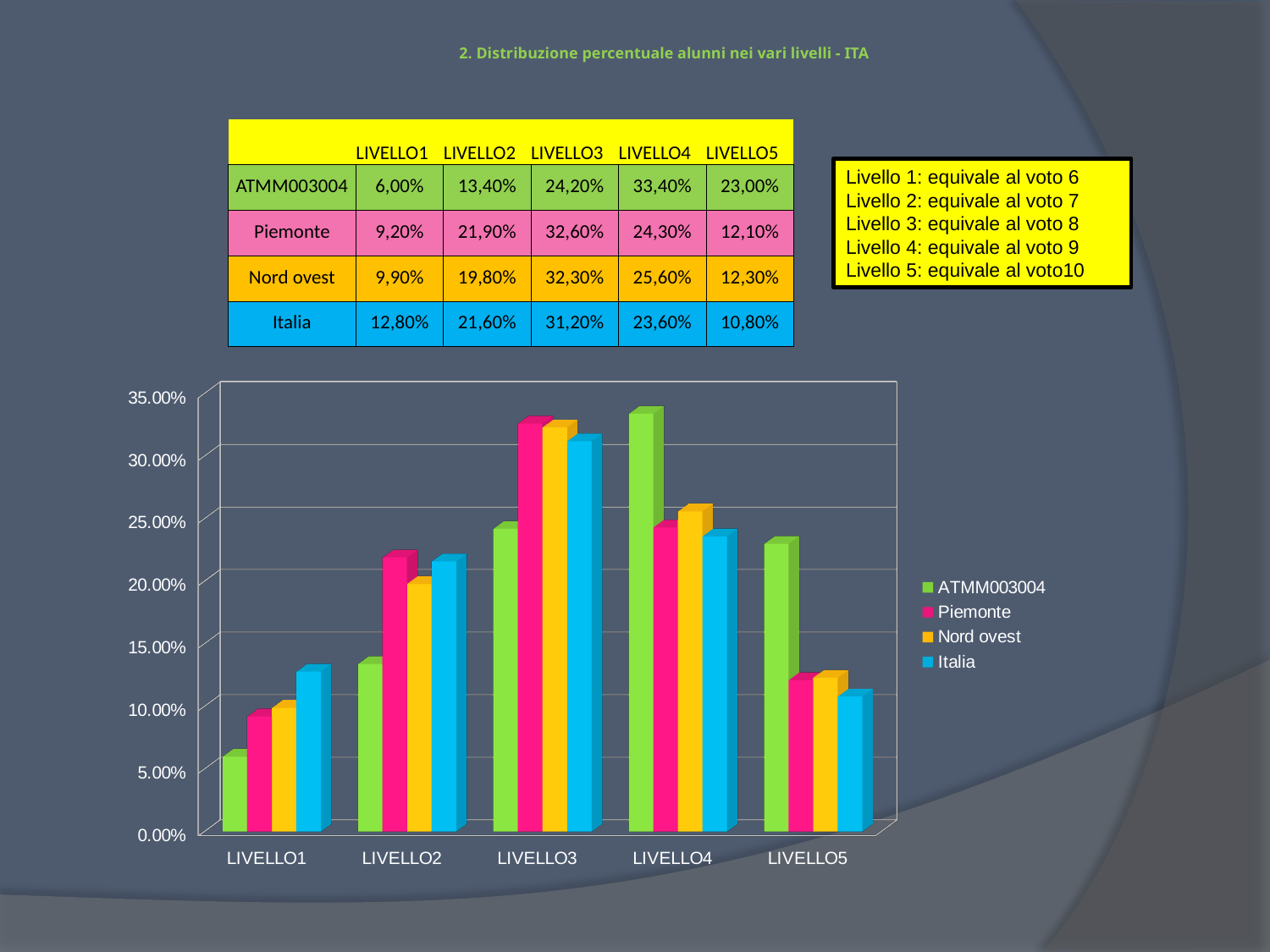
According to the table, what is the value for Italia at LIVELLO1? 12,80% Which series is shown in green in the chart legend? ATMM003004 What kind of chart is shown on the slide? bar chart What is the difference between the ATMM003004 and Italia values at LIVELLO5? 12,20% How many series does the chart legend list? 4 Is the value for Piemonte at LIVELLO3 greater or less than 30.00%? greater According to the table, what is the value for Piemonte at LIVELLO3? 32,60% How many categories (livelli) are shown on the x axis of the chart? 5 Which livello has the lowest value for the ATMM003004 series? LIVELLO1 According to the table, what is the value for ATMM003004 at LIVELLO4? 33,40% At LIVELLO1, which is larger: the value for ATMM003004 or the value for Italia? Italia Which livello has the highest value for the ATMM003004 series? LIVELLO4